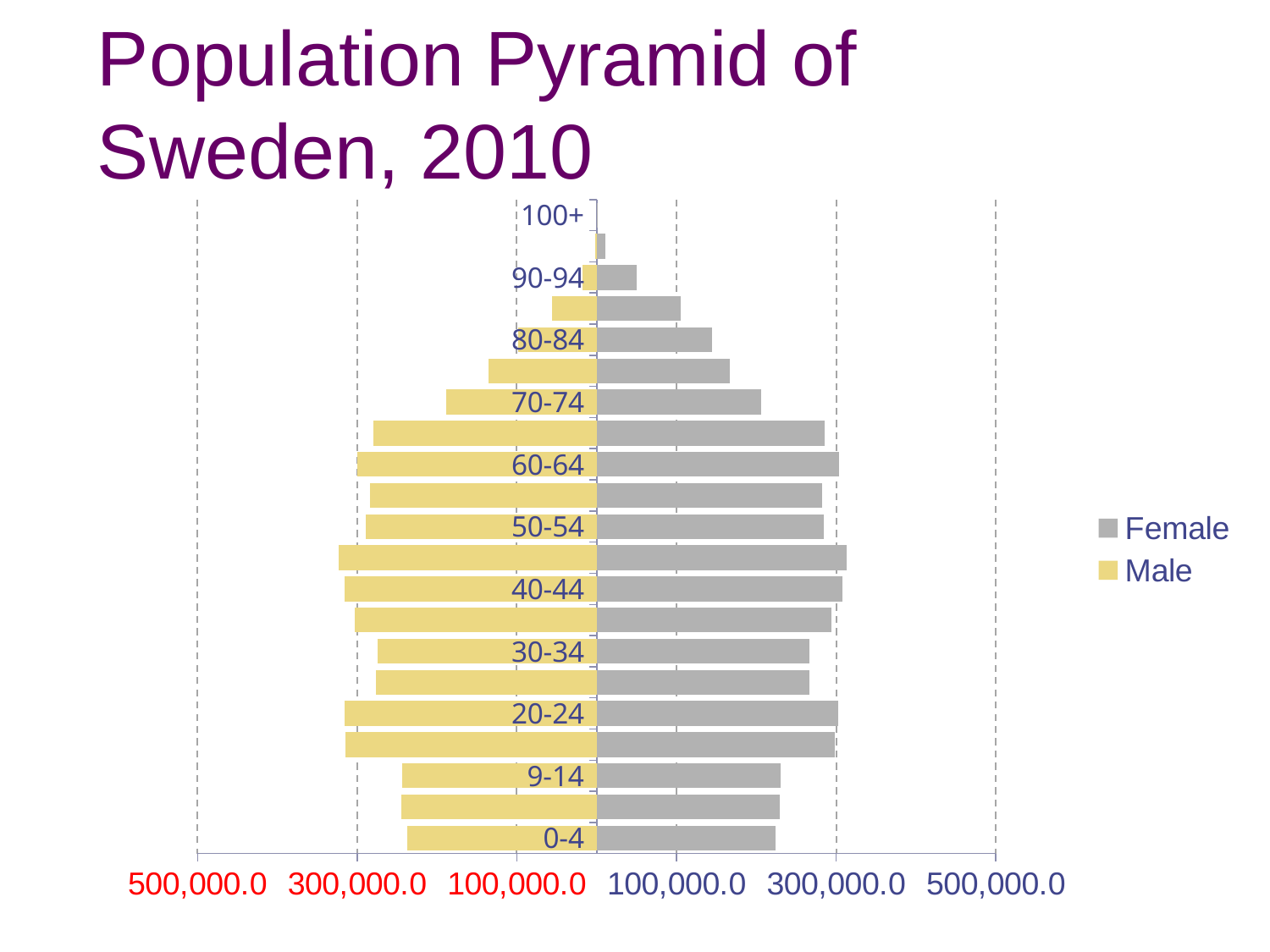
Moving from the 60-64 age group up to the 100+ age group, do the Female bars get longer or shorter? shorter Is the Female value for the 90-94 age group greater or less than 100,000.0? less How many series does the legend list? 2 Which age group has the smallest Female value? 100+ Which colour represents the Male series? yellow For the 90-94 age group, which is larger, the Female value or the Male value? Female Is the Male value for the 70-74 age group greater or less than 100,000.0? greater Is the Female value for the 80-84 age group greater or less than 100,000.0? greater What kind of chart is shown on the slide? bar chart What are the two series named in the legend? Female and Male